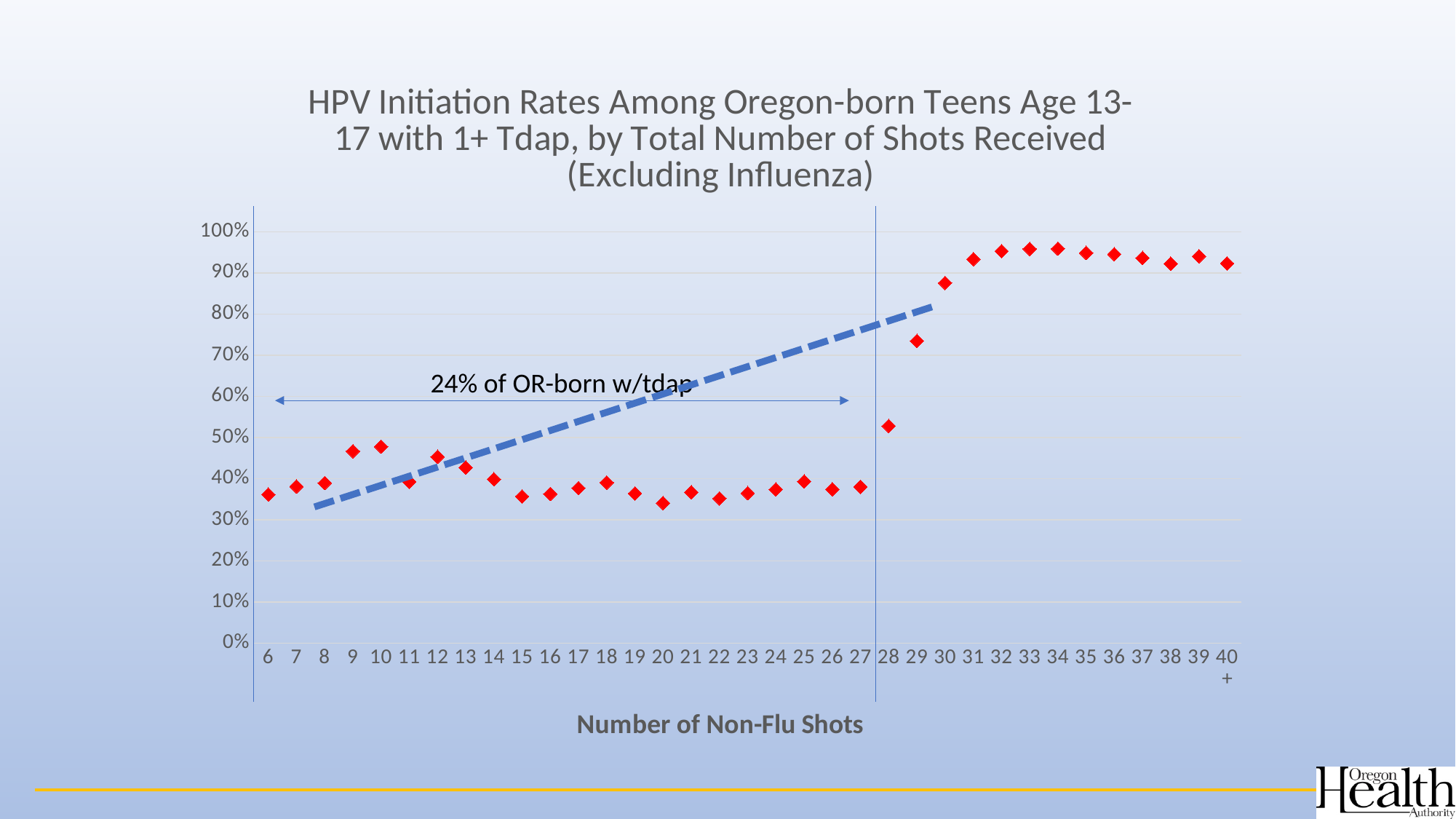
Is the HPV initiation rate for teens with 28 non-flu shots greater or less than 50%? greater Is the HPV initiation rate for teens with 33 non-flu shots greater or less than 90%? greater Which has the higher HPV initiation rate: teens with 28 non-flu shots or teens with 29 non-flu shots? 29 Is the HPV initiation rate for teens with 20 non-flu shots greater or less than 40%? less Which has the higher HPV initiation rate: teens with 10 non-flu shots or teens with 15 non-flu shots? 10 What kind of chart is shown on the slide? scatter chart How many data points are plotted along the x axis (from 6 to 40+)? 35 Do the HPV initiation rates rise or fall as the number of non-flu shots goes from 27 to 33? rise What is the title of the x axis? Number of Non-Flu Shots